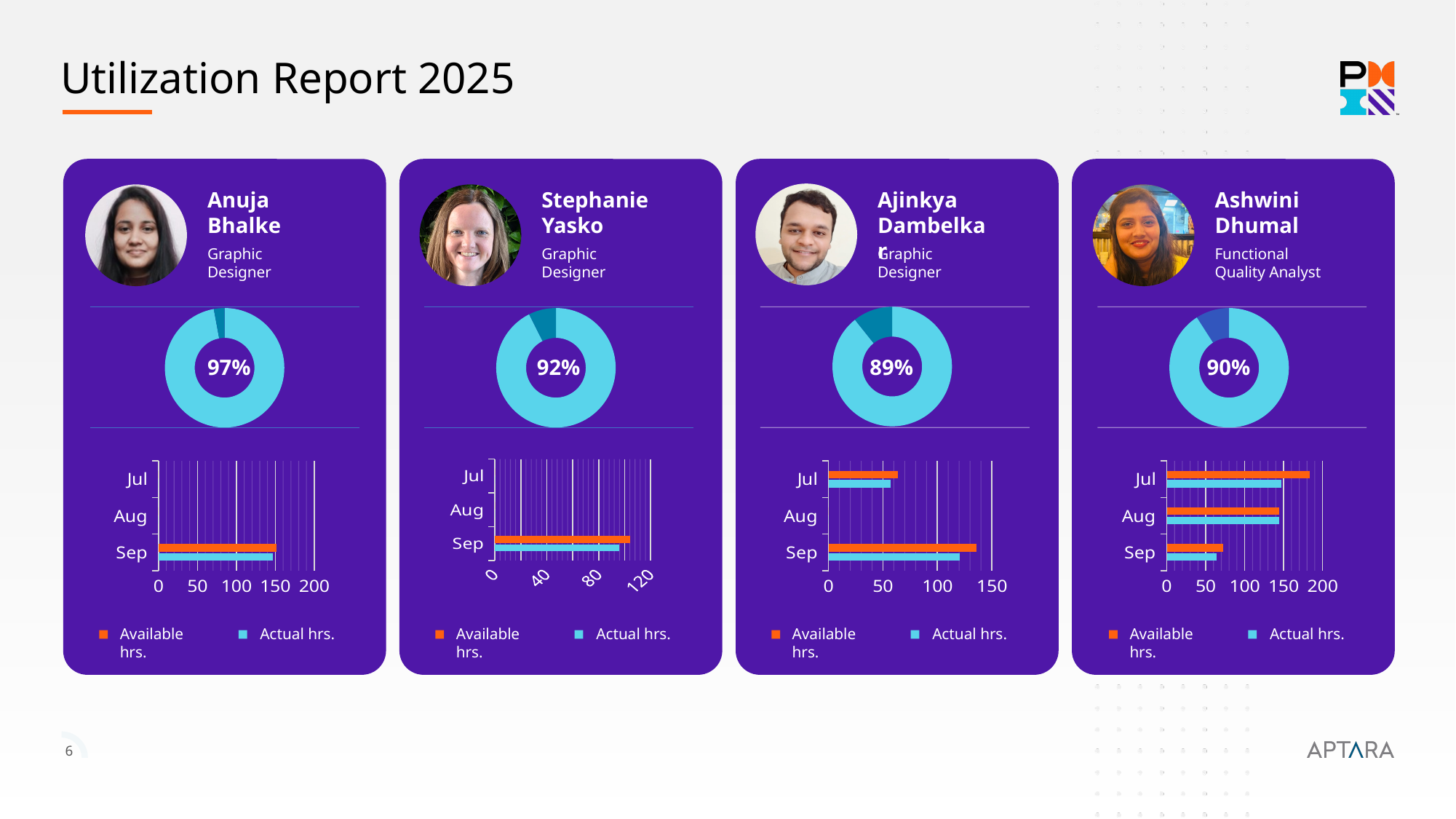
On Ajinkya Dambelka's bar chart, is the Available hrs. value for Sep greater or less than 100? greater What kind of chart is the monthly hours chart on Stephanie Yasko's card? bar chart On Ashwini Dhumal's bar chart, is the Available hrs. value for Jul greater or less than 150? greater Across the four donut charts, which person has the lowest utilization percentage? Ajinkya Dambelka On Anuja Bhalke's card, what utilization percentage is shown in the centre of the donut chart? 97% Comparing the donut charts, who has the higher utilization percentage, Ashwini Dhumal or Ajinkya Dambelka? Ashwini Dhumal Across the four donut charts, which person has the highest utilization percentage? Anuja Bhalke On Ajinkya Dambelka's bar chart, is the Actual hrs. value for Jul greater or less than 100? less On Ajinkya Dambelka's card, what utilization percentage is shown in the donut chart? 89% How many months are listed on the axis of Anuja Bhalke's bar chart? 3 How many series does the legend list on Ashwini Dhumal's bar chart? 2 What is the difference between Anuja Bhalke's and Stephanie Yasko's donut chart percentages? 5%